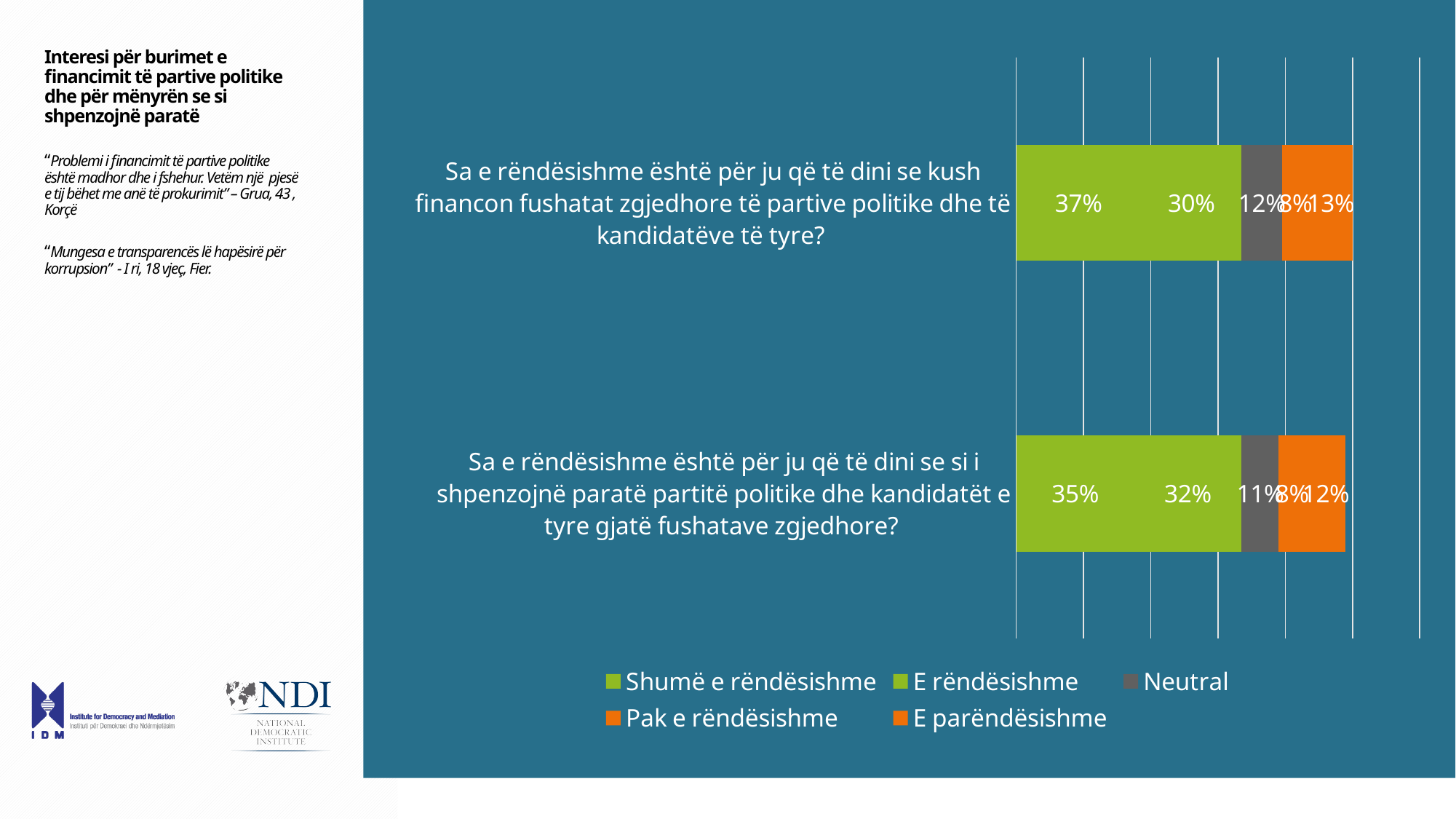
Which bar has the larger "E rëndësishme" share: the top bar (who finances campaigns) or the bottom bar (how parties spend money)? The bottom bar (how parties spend money), 32% In the stacked bar for the question about who finances election campaigns (top bar), what percentage answered "Shumë e rëndësishme"? 37% How many survey questions (bars) are plotted in the chart? 2 What is the "Neutral" share for the top bar (who finances election campaigns)? 12% How many response categories does the legend list? 5 What is the "Pak e rëndësishme" share for the top bar (who finances election campaigns)? 8% By how many percentage points does the "Shumë e rëndësishme" share of the top bar (37%) exceed that of the bottom bar (35%)? 2 percentage points Which response category has the largest share in the bottom bar (how parties spend money)? Shumë e rëndësishme What is the "E parëndësishme" share for the bottom bar (how parties spend money)? 12% What is the total of all segments in the top bar (who finances election campaigns)? 100% In the stacked bar for the question about how parties spend money during campaigns (bottom bar), what percentage answered "E rëndësishme"? 32% What type of chart is shown on the slide? Stacked horizontal bar chart